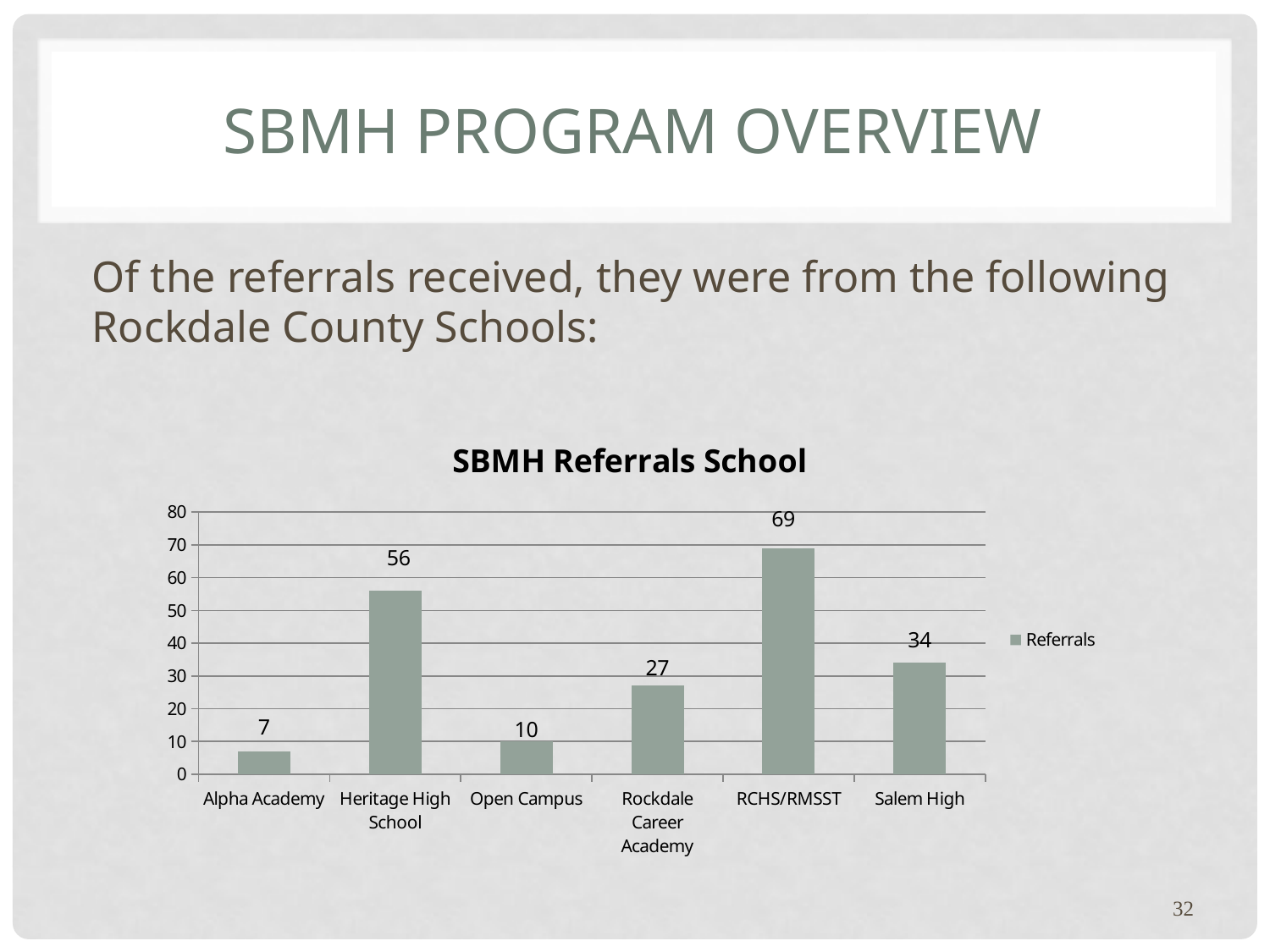
Is the value for Open Campus greater or less than 20? less What type of chart is shown? Bar chart How many series does the legend list? 1 What is the value for Rockdale Career Academy? 27 How many schools are shown on the x axis? 6 How many referrals came from Heritage High School? 56 Which school has the lowest number of referrals? Alpha Academy Which has more referrals, Salem High or Rockdale Career Academy? Salem High What is the difference in referrals between Heritage High School and Open Campus? 46 How many referrals came from Alpha Academy? 7 What is the difference in referrals between RCHS/RMSST and Salem High? 35 Which school has the highest number of referrals? RCHS/RMSST